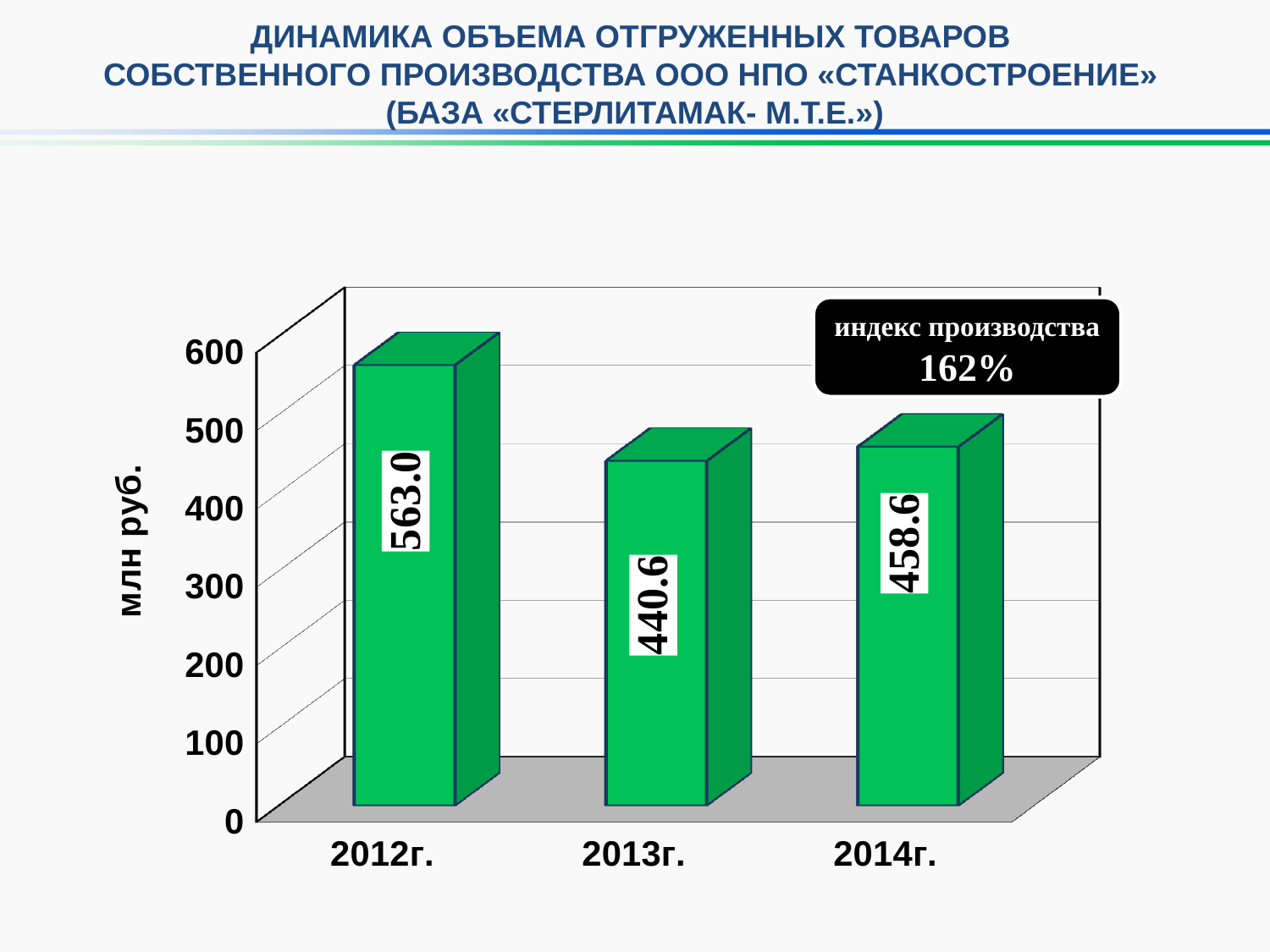
What is the value for 2012г.? 563.0 Is the value for 2012г. greater or less than 500? greater What is the value for 2014г.? 458.6 What kind of chart is shown on the slide? bar chart Which year has the lowest value? 2013г. What is the value for 2013г.? 440.6 What is the difference between the values for 2012г. and 2013г.? 122.4 What unit is given on the vertical axis label? млн руб. Which year has the highest value? 2012г. Which is larger, the value for 2014г. or the value for 2013г.? 2014г. How many years are shown on the x axis? 3 What is the difference between the values for 2014г. and 2013г.? 18.0